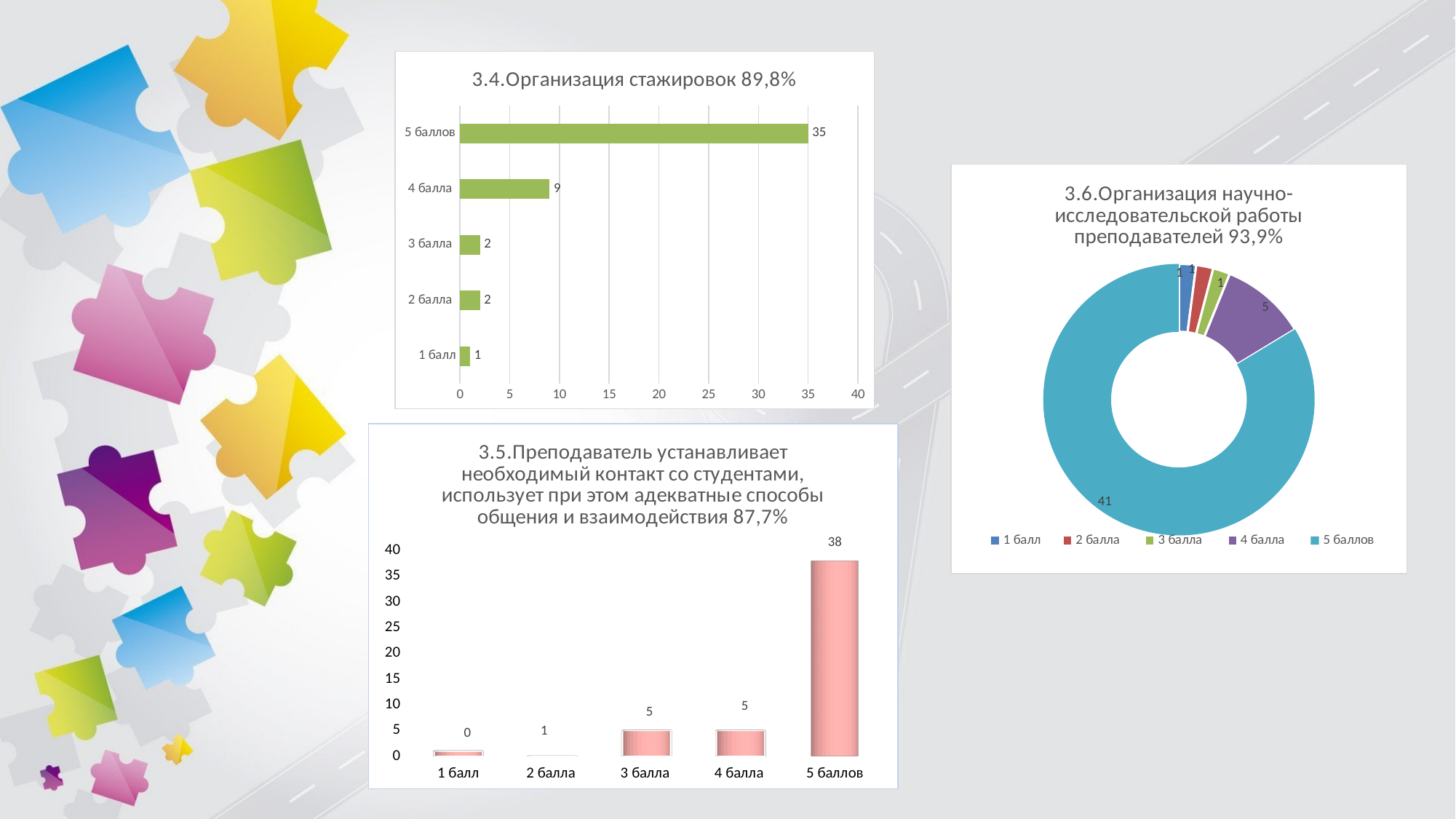
How many entries does the legend of the chart '3.6.Организация научно-исследовательской работы преподавателей 93,9%' list? 5 What kind of chart is '3.4.Организация стажировок 89,8%'? Bar chart In the chart '3.6.Организация научно-исследовательской работы преподавателей 93,9%', which category has the largest slice? 5 баллов In the chart '3.4.Организация стажировок 89,8%', which category has the lowest value? 1 балл In the chart '3.6.Организация научно-исследовательской работы преподавателей 93,9%', what is the value for '4 балла'? 5 In the chart '3.4.Организация стажировок 89,8%', what is the value for '4 балла'? 9 In the chart '3.5.Преподаватель устанавливает необходимый контакт со студентами...', what is the value for '5 баллов'? 38 In the chart '3.4.Организация стажировок 89,8%', what is the difference between the values for '5 баллов' and '4 балла'? 26 In the chart '3.4.Организация стажировок 89,8%', what is the value for '5 баллов'? 35 In the chart '3.5.Преподаватель устанавливает необходимый контакт со студентами...', how many categories are shown on the x axis? 5 In the chart '3.5.Преподаватель устанавливает необходимый контакт со студентами...', which is larger, the value for '3 балла' or the value for '5 баллов'? 5 баллов